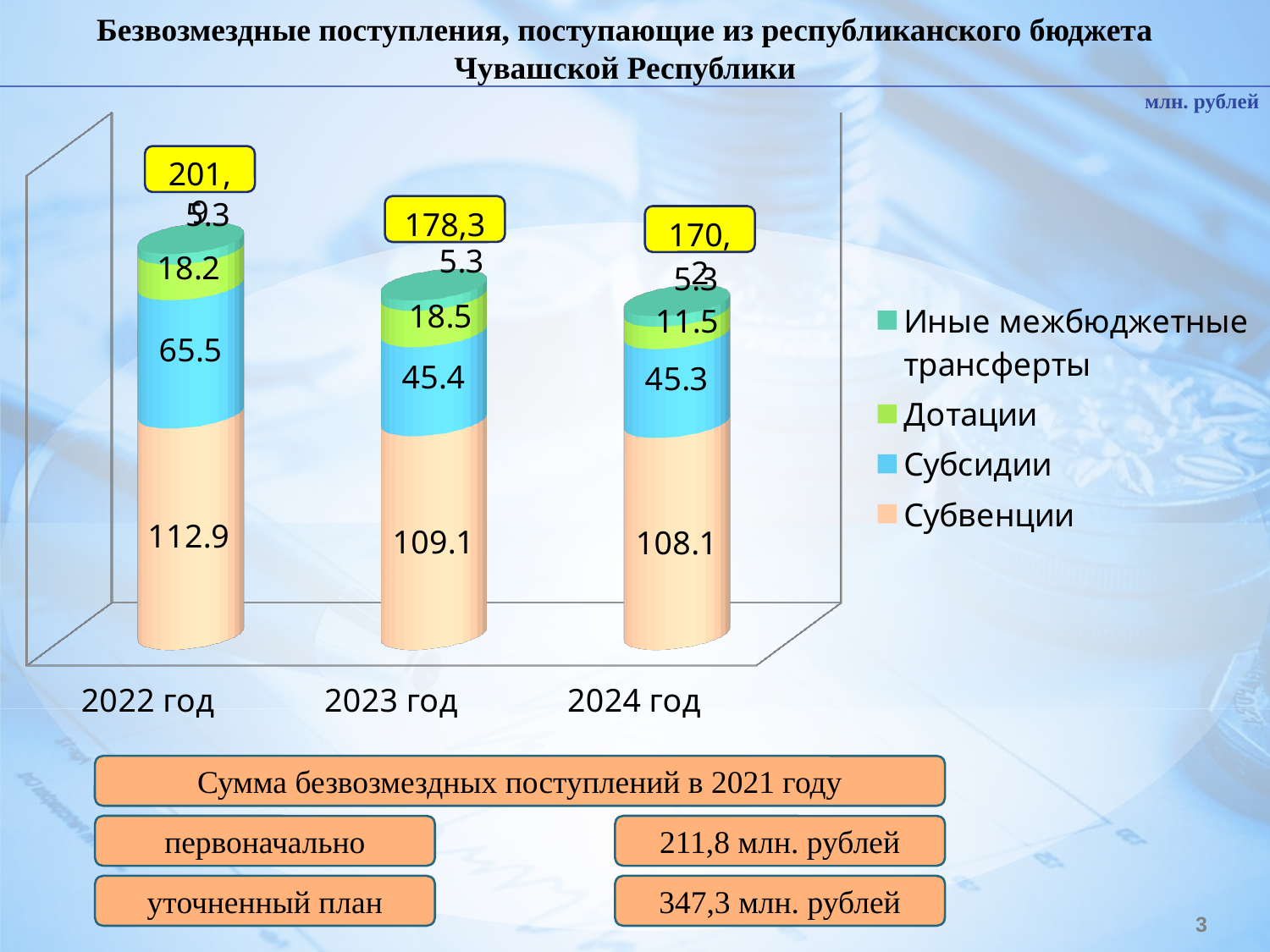
What is the total shown above the bar for 2023 год? 178,3 How many years (categories) are shown on the x axis? 3 What is the value of Субсидии for 2023 год? 45.4 What is the difference between Субсидии in 2022 год and 2023 год? 20.1 What is the value of Иные межбюджетные трансферты for 2023 год? 5.3 Which year has the lowest value of Субвенции? 2024 год What is the value of Субвенции for 2022 год? 112.9 What kind of chart is shown on the slide? stacked bar chart Which year has the highest value of Субсидии? 2022 год Do the Субвенции values rise or fall from 2022 год to 2024 год? fall How many series does the legend list? 4 What is the value of Дотации for 2024 год? 11.5